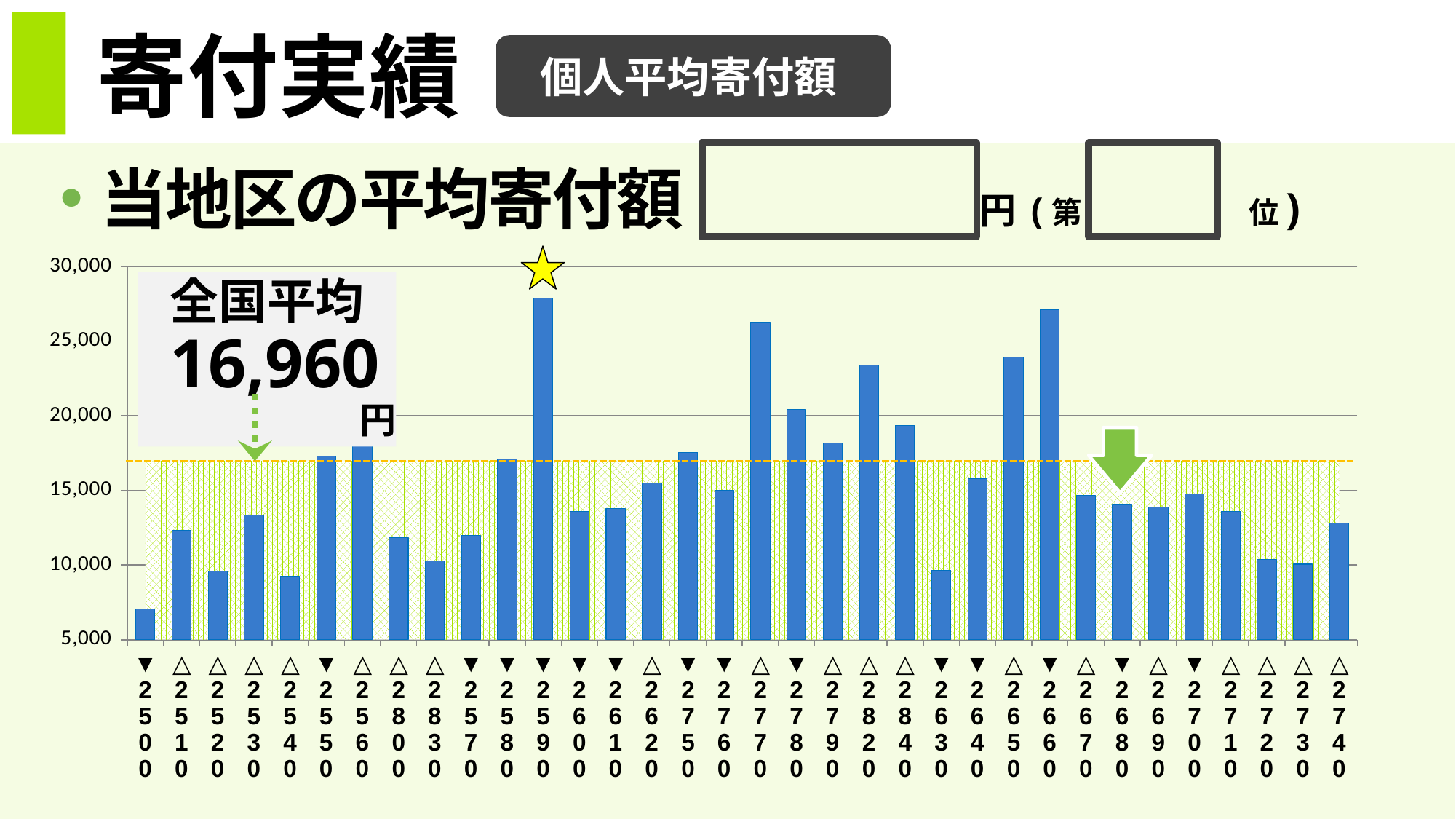
Is the value for 2630 greater or less than 10,000? less Is the value for 2820 greater or less than 20,000? greater What does the horizontal dashed line across the chart represent? 全国平均 (national average) Which category has the lowest bar in the chart? 2500 Which category has the highest bar in the chart? 2590 Which is larger, the value for 2770 or the value for 2780? 2770 Is the value for 2590 greater or less than 25,000? greater What kind of chart is shown on the slide? bar chart What national average value (全国平均) is printed on the chart? 16,960 How many bars (categories) are plotted in the chart? 34